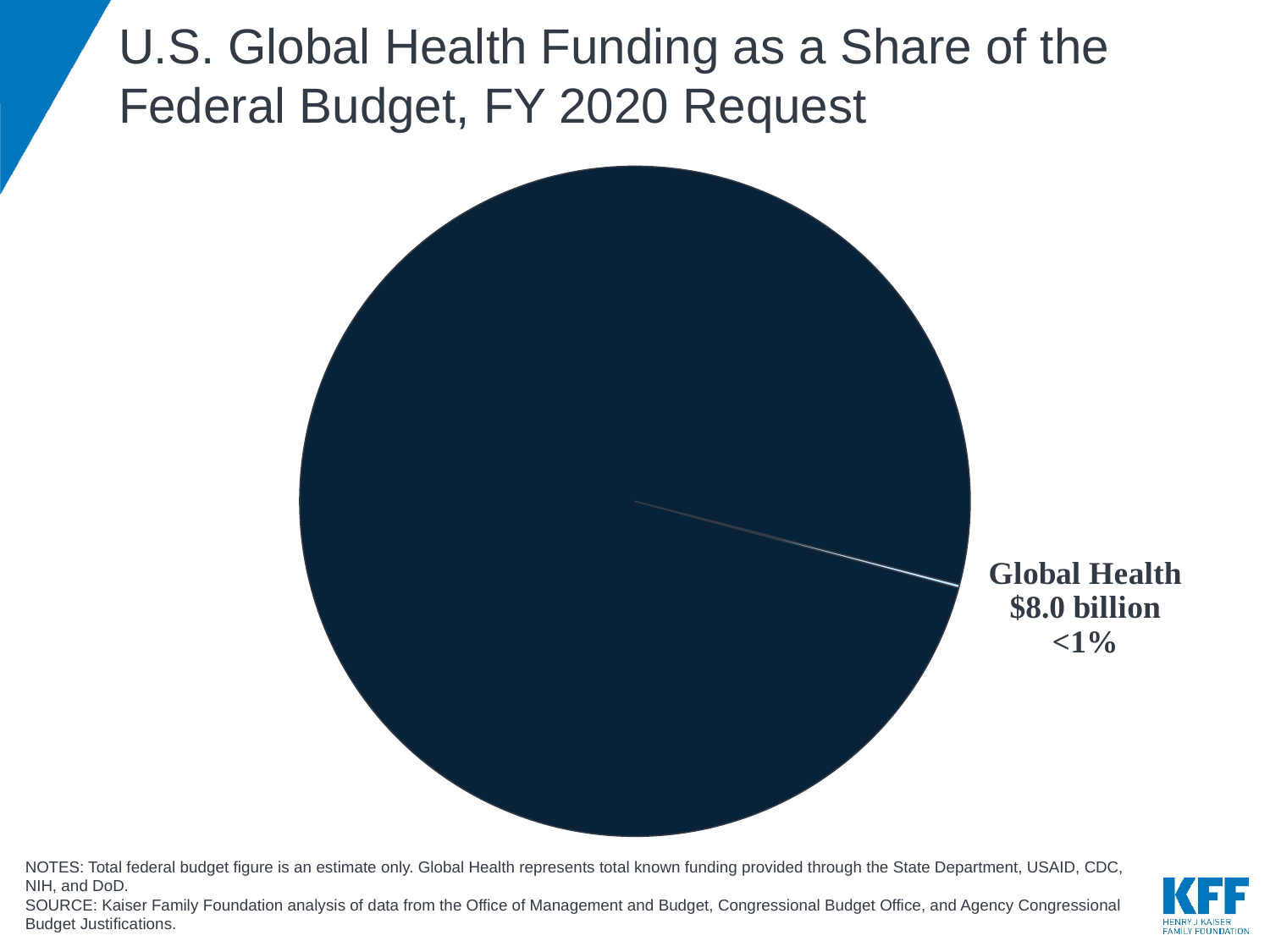
What is the title of the slide's chart? U.S. Global Health Funding as a Share of the Federal Budget, FY 2020 Request Which is larger in the pie chart: the Global Health slice or the rest of the federal budget? the rest of the federal budget What kind of chart is shown on the slide? pie chart Which fiscal year request does the chart refer to? FY 2020 Which slice of the pie chart is the smallest? Global Health What is the dollar amount shown for Global Health in the pie chart? $8.0 billion How many slices does the pie chart have? 2 What share of the federal budget does the Global Health slice represent, according to the label? <1%